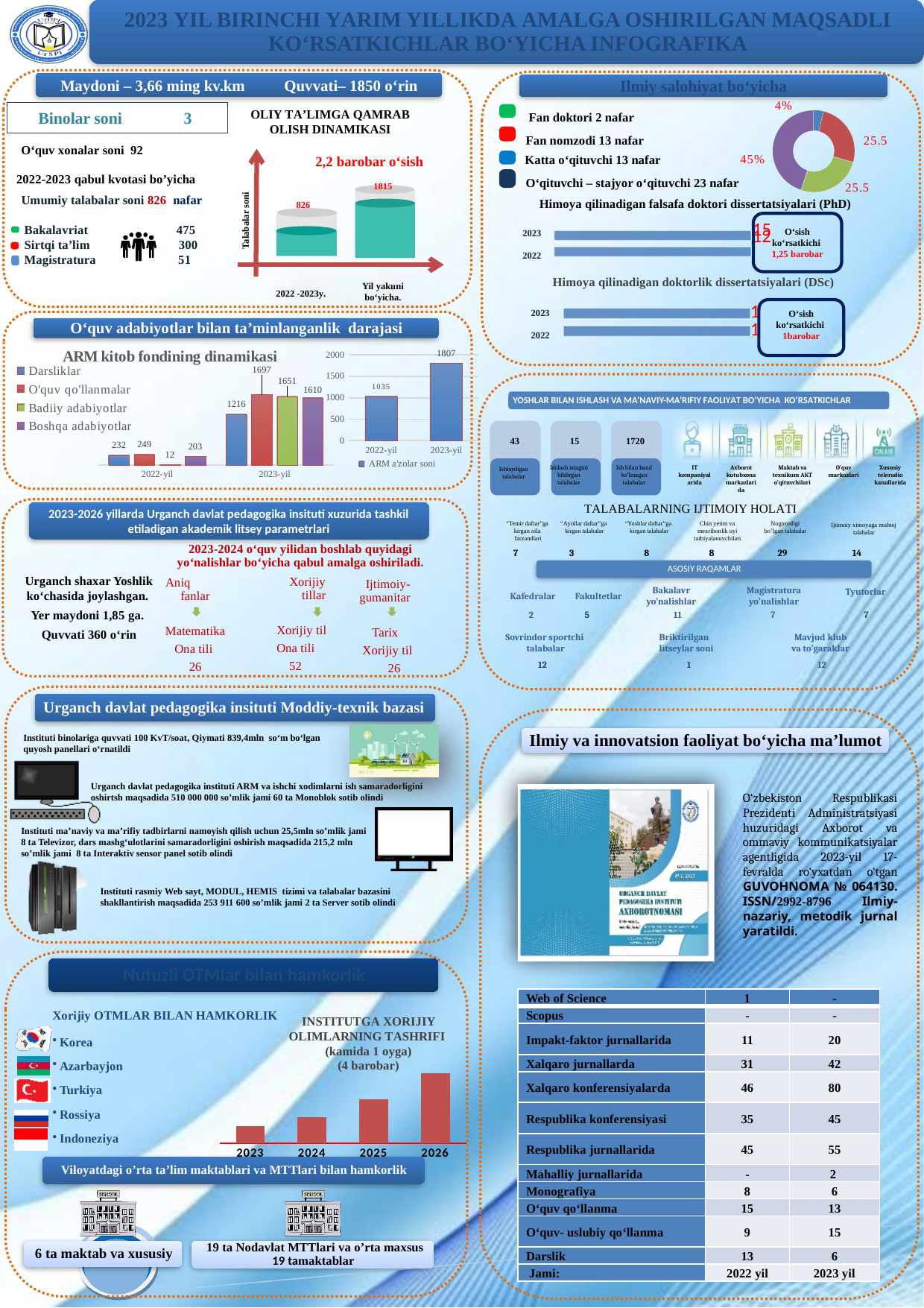
In the 'ARM kitob fondining dinamikasi' chart, what is the value for Darsliklar in 2022-yil? 232 In the 'ARM kitob fondining dinamikasi' chart, what is the difference between O'quv qo'llanmalar and Badiiy adabiyotlar in 2023-yil? 46 In the 'ARM a'zolar soni' chart, what is the difference between 2023-yil and 2022-yil? 772 In the 'INSTITUTGA XORIJIY OLIMLARNING TASHRIFI' chart, do the values rise or fall from 2023 to 2026? rise How many series does the legend of the 'ARM kitob fondining dinamikasi' chart list? 4 In the 'ARM kitob fondining dinamikasi' chart, which category has the highest value in 2023-yil? O'quv qo'llanmalar In the 'Ilmiy salohiyat bo'yicha' pie chart, what is the largest share shown? 45% In the 'ARM a'zolar soni' chart, what is the value for 2022-yil? 1035 In the 'ARM kitob fondining dinamikasi' chart, which category has the lowest value in 2022-yil? Badiiy adabiyotlar In the 'Himoya qilinadigan falsafa doktori dissertatsiyalari (PhD)' chart, what is the value for 2023? 15 In the 'OLIY TA'LIMGA QAMRAB OLISH DINAMIKASI' chart, what is the value for 'Yil yakuni bo'yicha'? 1815 In the 'ARM kitob fondining dinamikasi' chart, what is the value for O'quv qo'llanmalar in 2023-yil? 1697